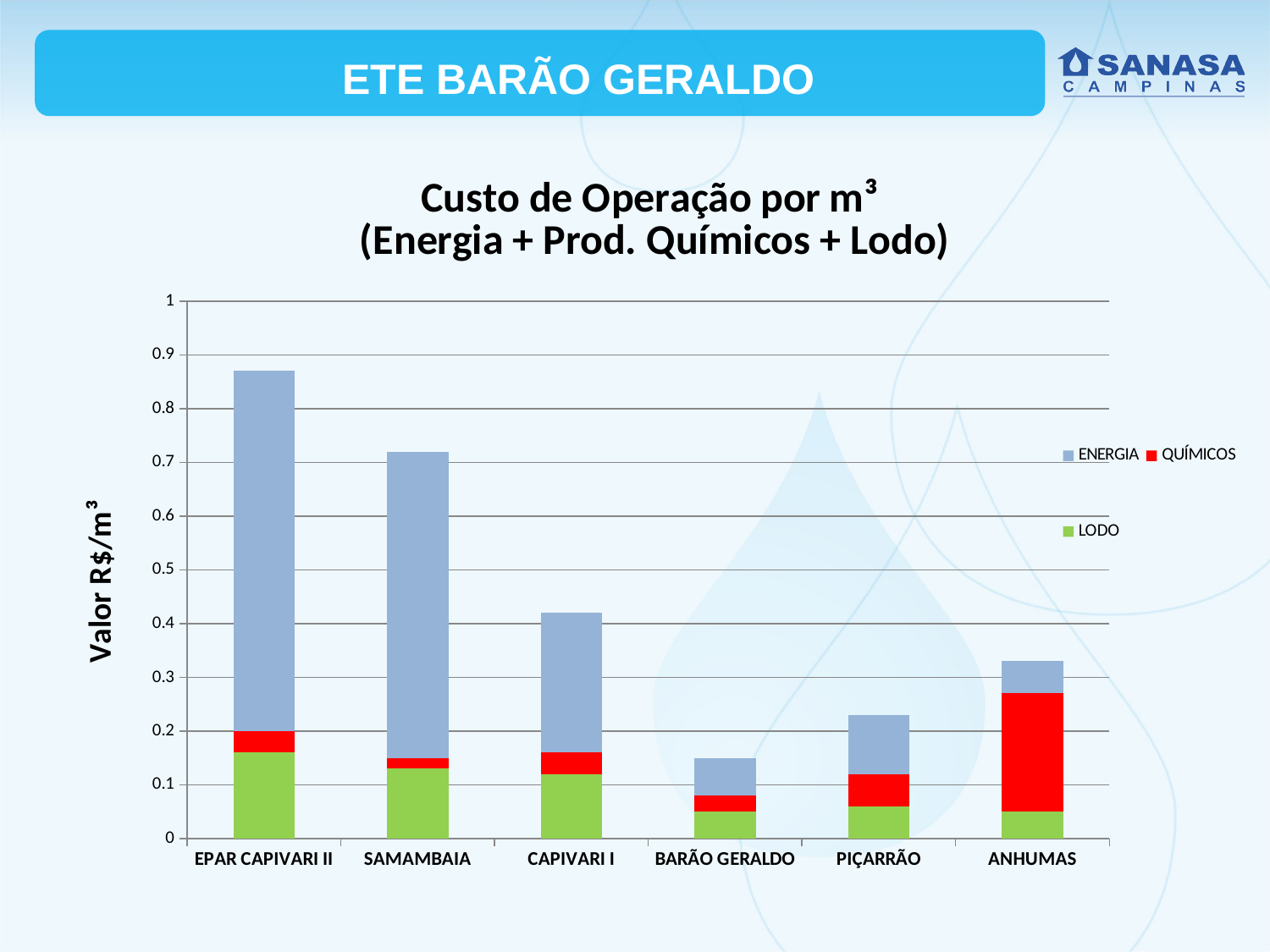
Which plant has the lowest total operating cost per m³? BARÃO GERALDO What kind of chart is shown on the slide? Stacked bar chart Which plant has the highest total operating cost per m³? EPAR CAPIVARI II Is the total value for BARÃO GERALDO greater or less than 0.2? less Which plant has the largest QUÍMICOS (red) segment? ANHUMAS Is the total value for CAPIVARI I greater or less than 0.5? less How many series does the legend list? 3 Which has the larger total operating cost, ANHUMAS or PIÇARRÃO? ANHUMAS What is the label of the y axis? Valor R$/m³ How many treatment plants (categories) are shown on the x axis? 6 Is the total value for SAMAMBAIA greater or less than 0.6? greater